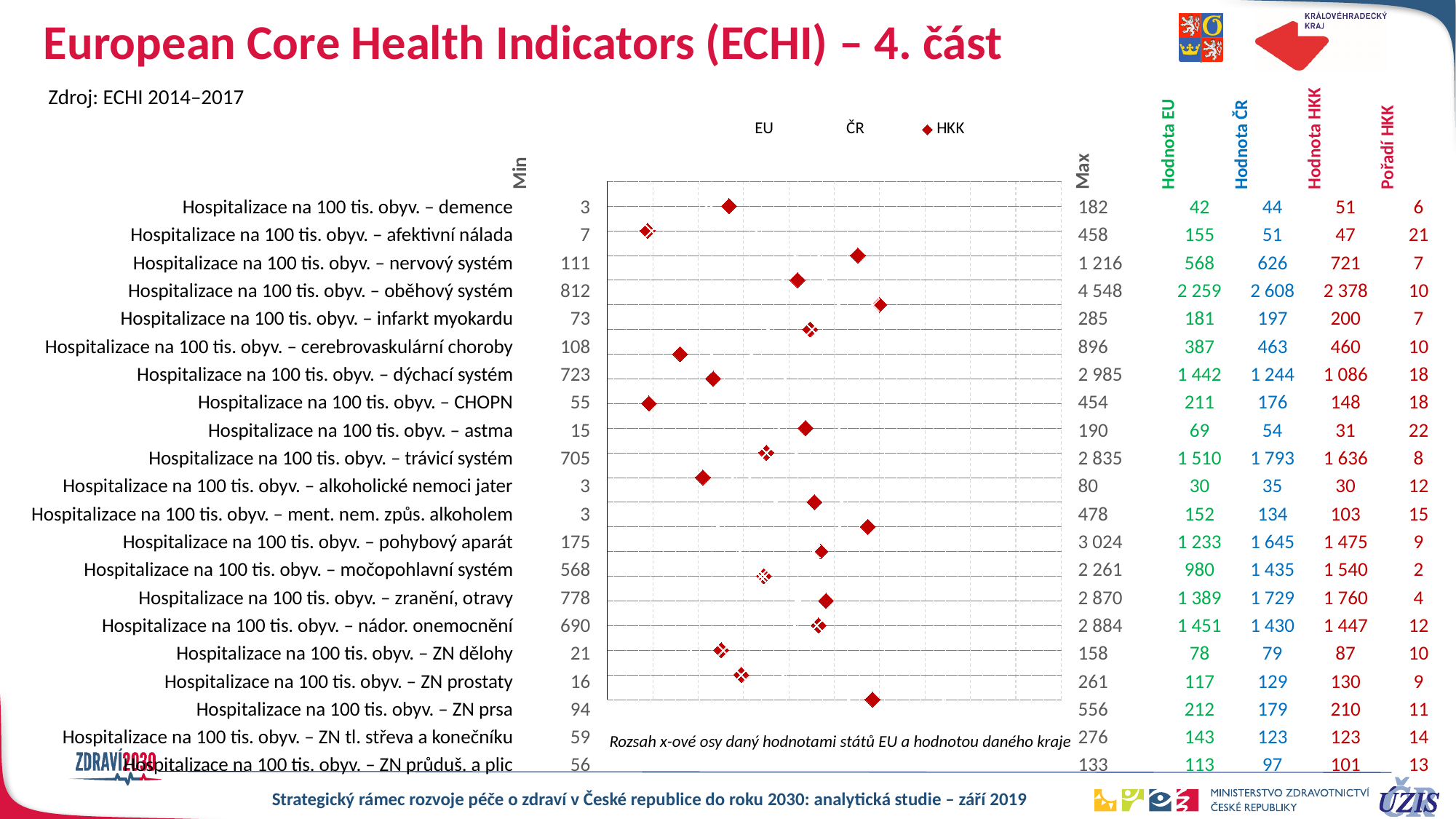
What is the difference between the Hodnota ČR and Hodnota HKK values for Hospitalizace na 100 tis. obyv. – dýchací systém? 158 For Hospitalizace na 100 tis. obyv. – astma, which is larger: the Hodnota EU value or the Hodnota HKK value? Hodnota EU What is the Max value shown for Hospitalizace na 100 tis. obyv. – nervový systém? 1 216 How many series does the chart legend list? 3 What is the Hodnota HKK value for Hospitalizace na 100 tis. obyv. – demence? 51 What is the Hodnota ČR value for Hospitalizace na 100 tis. obyv. – trávicí systém? 1 793 How many indicators (rows) are plotted in the chart? 21 Which indicator has the lowest Hodnota HKK value? Hospitalizace na 100 tis. obyv. – alkoholické nemoci jater What is the Pořadí HKK for Hospitalizace na 100 tis. obyv. – močopohlavní systém? 2 What kind of chart is shown on the slide? Scatter (dot) chart Which indicator has the highest Hodnota HKK value? Hospitalizace na 100 tis. obyv. – oběhový systém What is the Hodnota EU value for Hospitalizace na 100 tis. obyv. – oběhový systém? 2 259